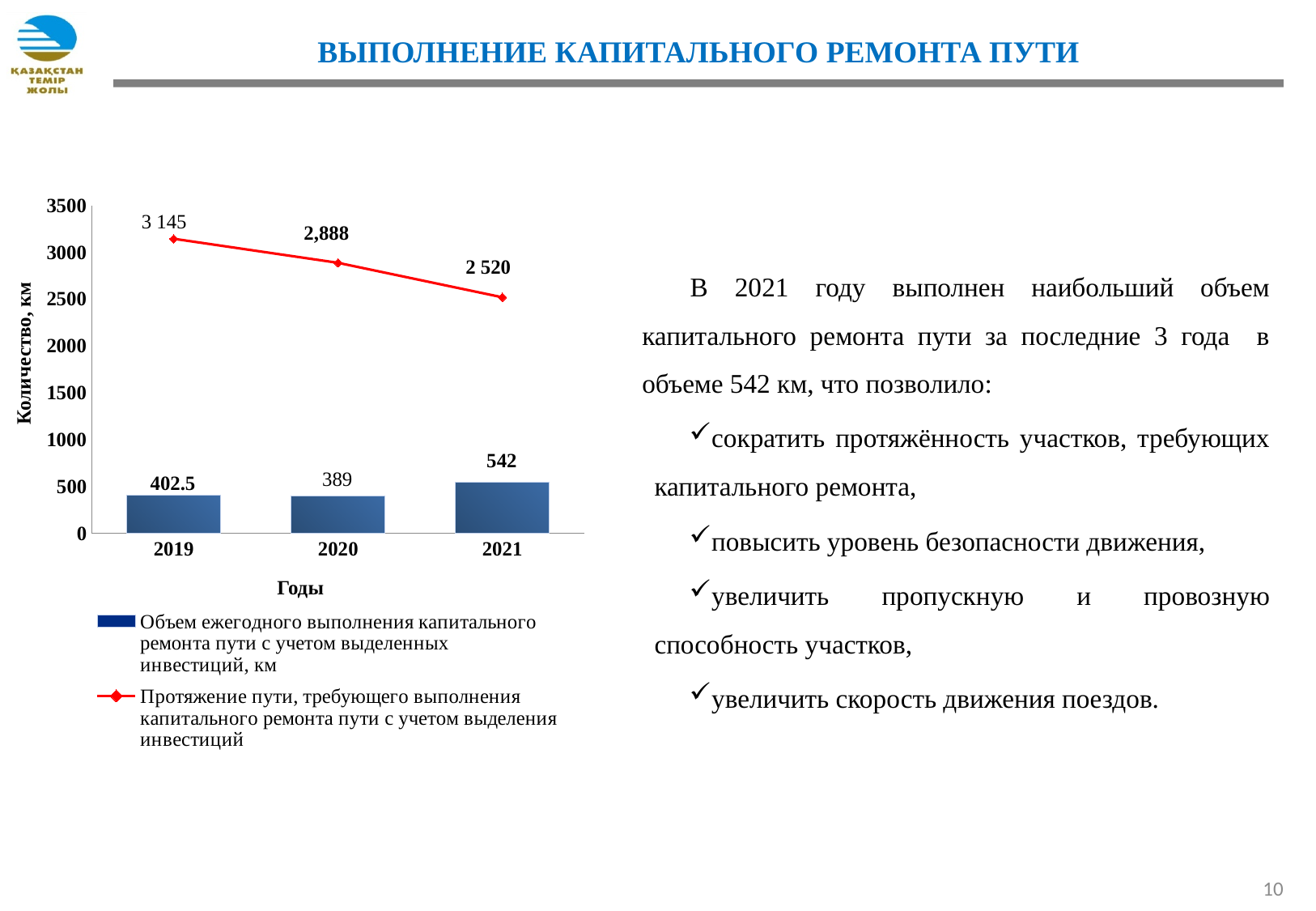
Which year has the highest bar value? 2021 Which is larger, the bar value for 2019 or for 2020? 2019 What is the value of the bar for 2019? 402.5 Does the red line series rise or fall from 2019 to 2021? fall How many series does the legend list? 2 What is the value of the bar for 2021? 542 Which year has the lowest bar value? 2020 What is the difference between the bar values for 2021 and 2020? 153 What is the difference between the red line values for 2019 and 2021? 625 What is the label of the vertical axis? Количество, км What is the value of the red line series for 2020? 2,888 What is the value of the red line series for 2019? 3 145